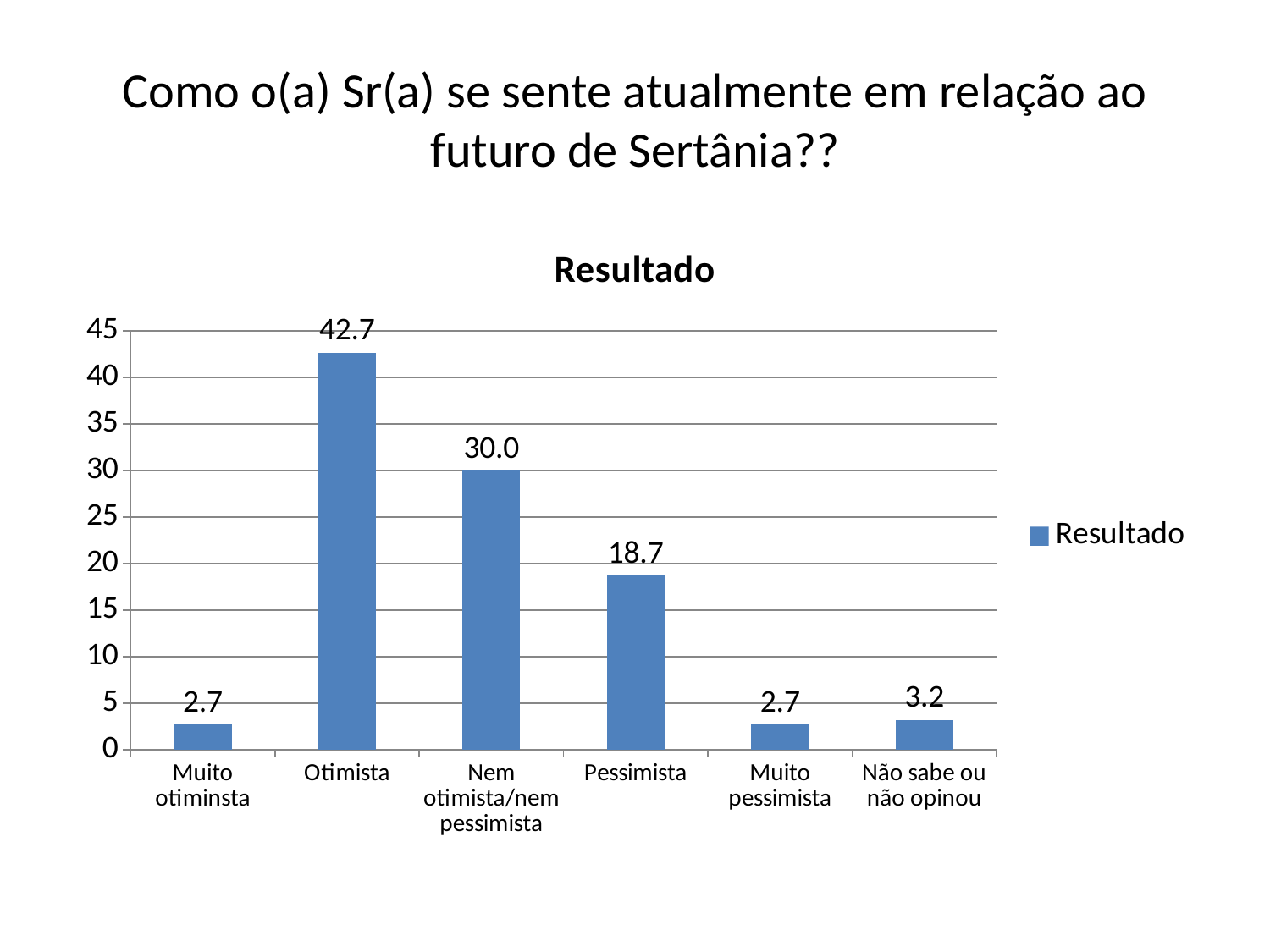
What is the title of the chart? Resultado Which is larger, the value for Nem otimista/nem pessimista or the value for Pessimista? Nem otimista/nem pessimista What is the value for Não sabe ou não opinou? 3.2 What kind of chart is shown? bar chart Is the value for Otimista greater or less than 40? greater What is the difference between the values for Pessimista and Não sabe ou não opinou? 15.5 What is the value for Otimista? 42.7 What is the difference between the values for Otimista and Nem otimista/nem pessimista? 12.7 Which category has the highest value? Otimista How many series does the legend list? 1 What is the value for Pessimista? 18.7 How many categories are shown on the x axis? 6